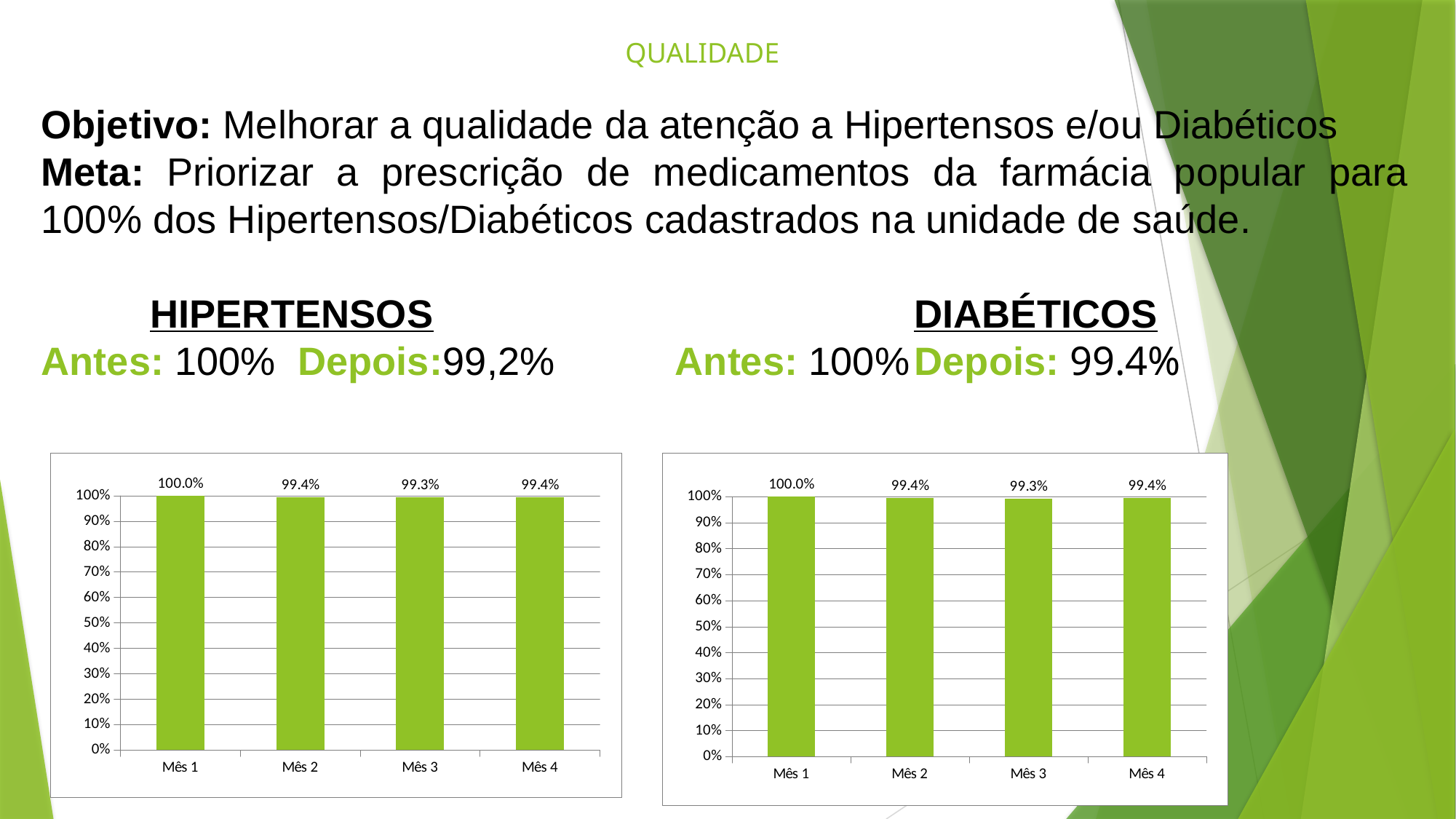
In the left chart, what is the value for Mês 3? 99.3% In the right chart, what is the value for Mês 4? 99.4% In the left chart, what is the value for Mês 1? 100.0% In the left chart, is the value for Mês 4 greater or less than 90%? greater In the left chart, what is the difference between the values for Mês 1 and Mês 2? 0.6% In the right chart, which month has the lowest value? Mês 3 How many months are shown on the x axis of the right chart? 4 In the right chart, which is larger, the value for Mês 1 or the value for Mês 3? Mês 1 In the right chart, what is the value for Mês 2? 99.4% In the left chart, which month has the highest value? Mês 1 What colour are the bars in the right chart? green What kind of chart is the left chart? bar chart